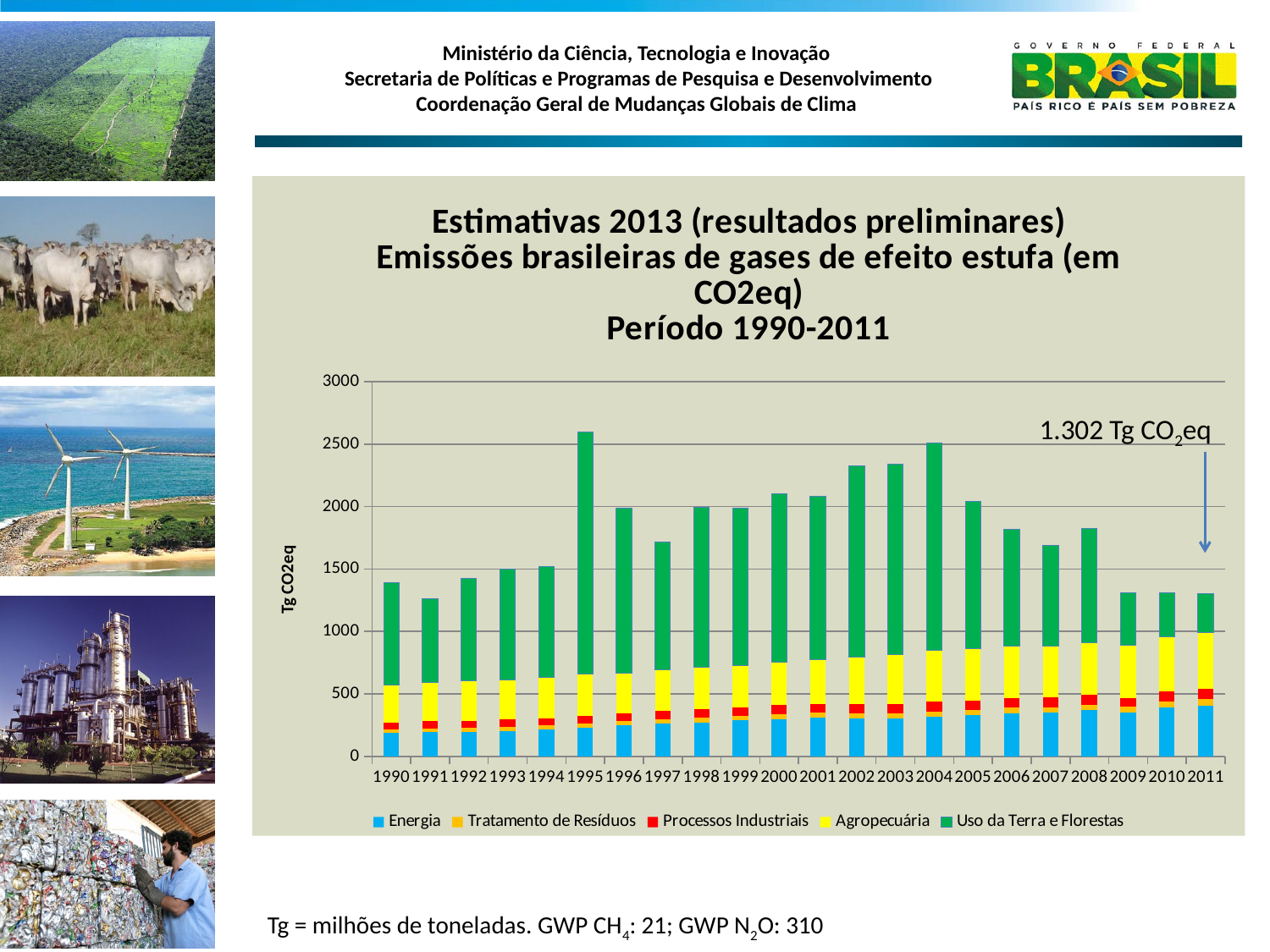
Is the total emissions value for 1990 greater or less than 1500? less Which series contributes the most to total emissions in 1995? Uso da Terra e Florestas Is the total emissions value for 2002 greater or less than 2000? greater What kind of chart is shown on the slide? bar chart How many series does the chart legend list? 5 Which year has larger total emissions, 1995 or 1996? 1995 What is the label on the y axis of the chart? Tg CO2eq How many years are shown along the x axis of the chart? 22 Is the total emissions value for 1995 greater or less than 2500? greater What total emission value is annotated for 2011 on the chart? 1.302 Tg CO2eq Which year has the highest total emissions in the chart? 1995 Does the Energia series rise or fall from 1990 to 2011? rise